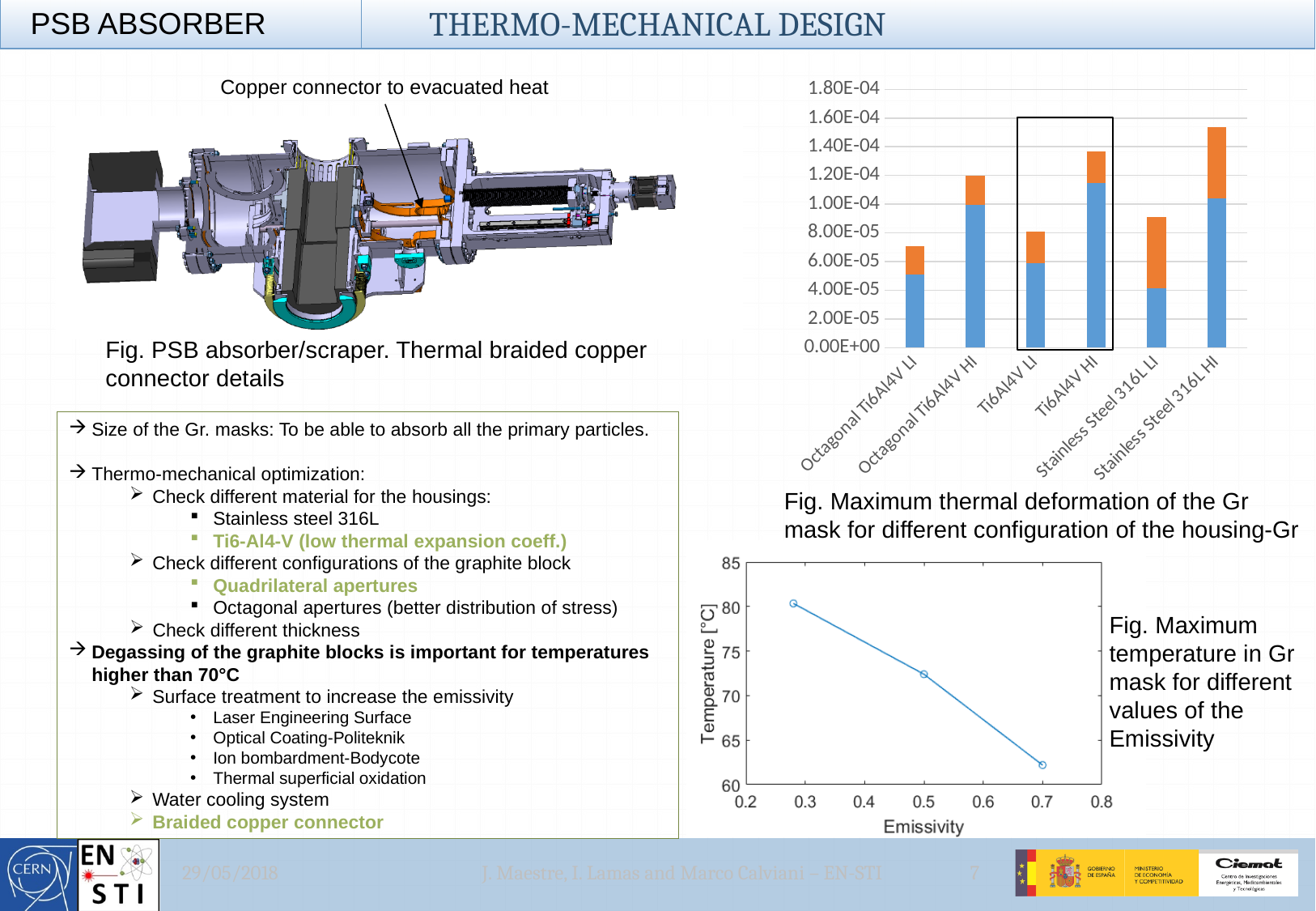
What is the x-axis label of the temperature chart at the bottom right? Emissivity In the temperature vs emissivity chart (bottom right), does the temperature rise or fall as emissivity increases? fall In the thermal deformation chart (top right), is the total bar for Stainless Steel 316L HI greater or less than 1.40E-04? greater In the temperature vs emissivity chart (bottom right), is the temperature at emissivity 0.7 greater or less than 65? less In the thermal deformation chart (top right), which total bar is larger: Ti6Al4V HI or Ti6Al4V LI? Ti6Al4V HI In the thermal deformation chart (top right), how many configurations are shown on the x axis? 6 What kind of chart is the thermal deformation chart at the top right? Stacked bar chart In the temperature vs emissivity chart (bottom right), how many data points are plotted? 3 In the thermal deformation chart (top right), which configuration has the highest total bar? Stainless Steel 316L HI In the thermal deformation chart (top right), which configuration is outlined with a black rectangle? Ti6Al4V LI and Ti6Al4V HI In the thermal deformation chart (top right), is the total bar for Octagonal Ti6Al4V LI greater or less than 8.00E-05? less In the thermal deformation chart (top right), which configuration has the lowest total bar? Octagonal Ti6Al4V LI